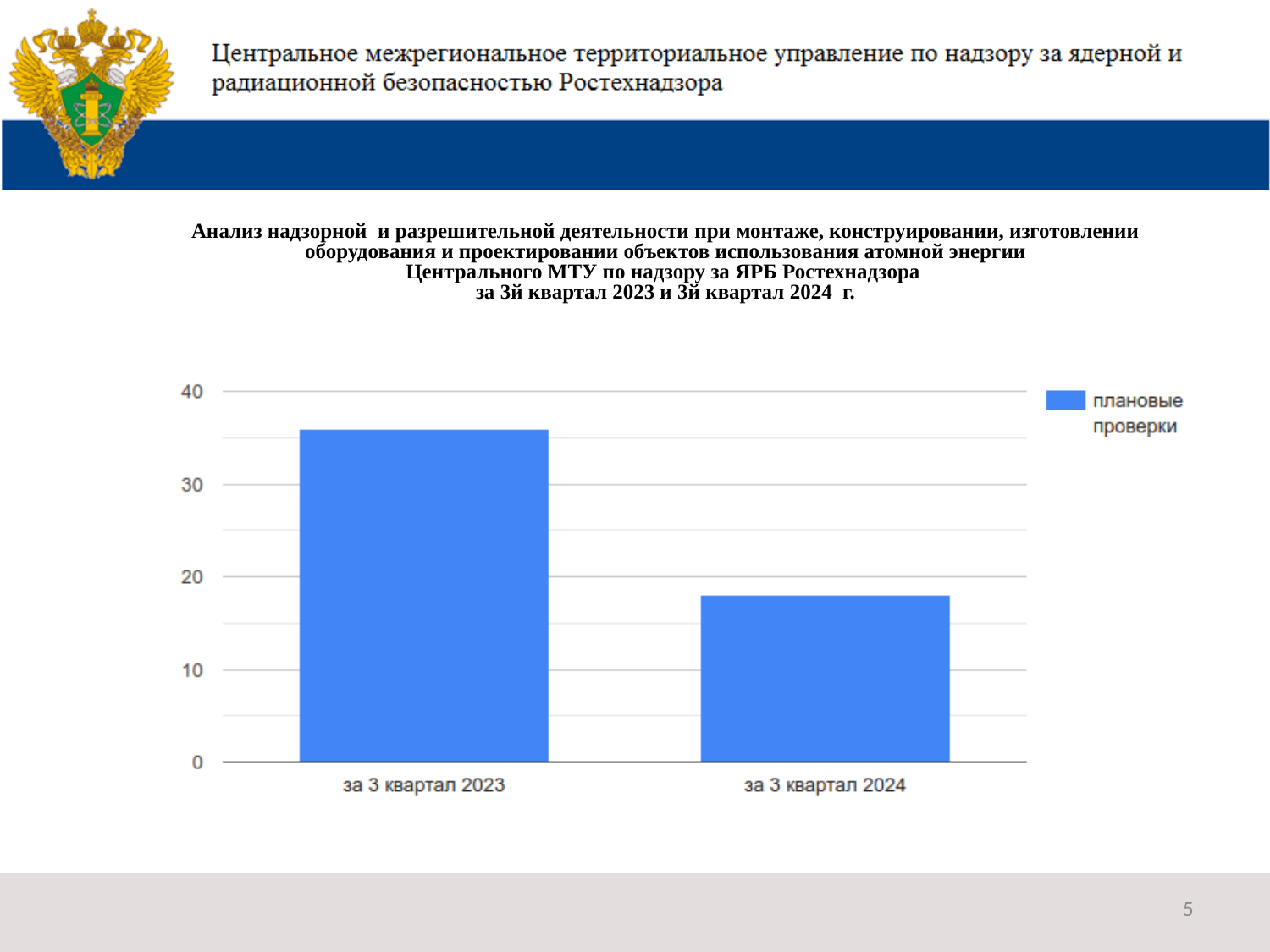
What is the name of the series shown in the chart legend? плановые проверки Do the values of плановые проверки rise or fall from за 3 квартал 2023 to за 3 квартал 2024? fall Which category has the lowest value for плановые проверки? за 3 квартал 2024 Is the value for за 3 квартал 2024 greater or less than 20? less How many categories are shown on the x axis of the chart? 2 Is the value for за 3 квартал 2023 greater or less than 30? greater Is the value for за 3 квартал 2023 greater or less than 40? less Which category has the highest value for плановые проверки? за 3 квартал 2023 What kind of chart is shown on the slide? bar chart How many series does the chart legend list? 1 Which is larger: the value for за 3 квартал 2023 or the value for за 3 квартал 2024? за 3 квартал 2023